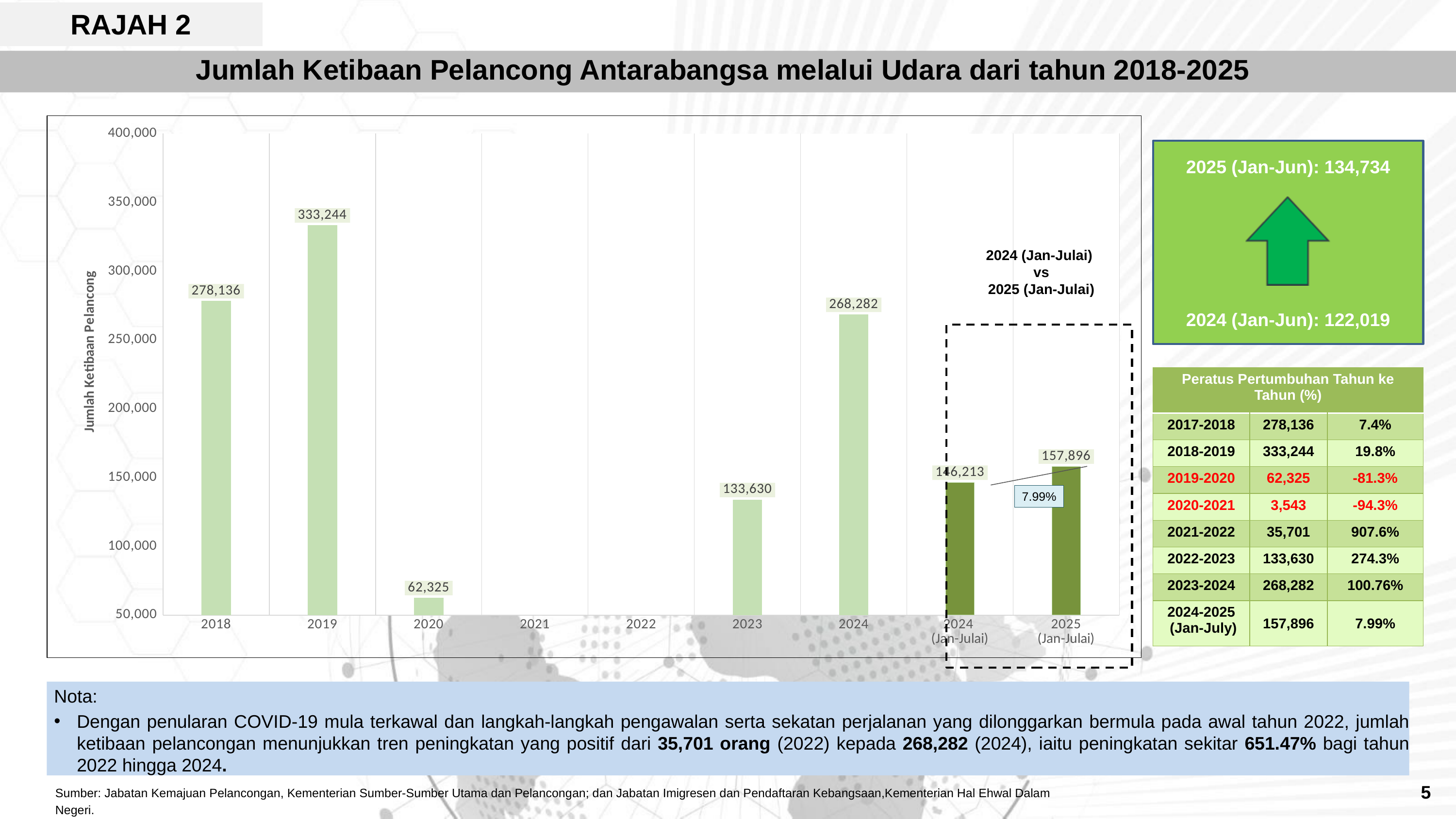
Is the value for 2018 greater or less than 250,000? greater What is the value for 2019? 333,244 How many categories are labelled on the x axis? 9 From 2023 to 2024, do the values rise or fall? rise Which year has the highest bar? 2019 What is the value for 2025 (Jan-Julai)? 157,896 What is the value for 2020? 62,325 What kind of chart is shown? bar chart Which is larger, the value for 2023 or the value for 2024? 2024 What is the difference between the values for 2019 and 2018? 55,108 What is the title of the y axis? Jumlah Ketibaan Pelancong What is the difference between the values for 2024 and 2023? 134,652